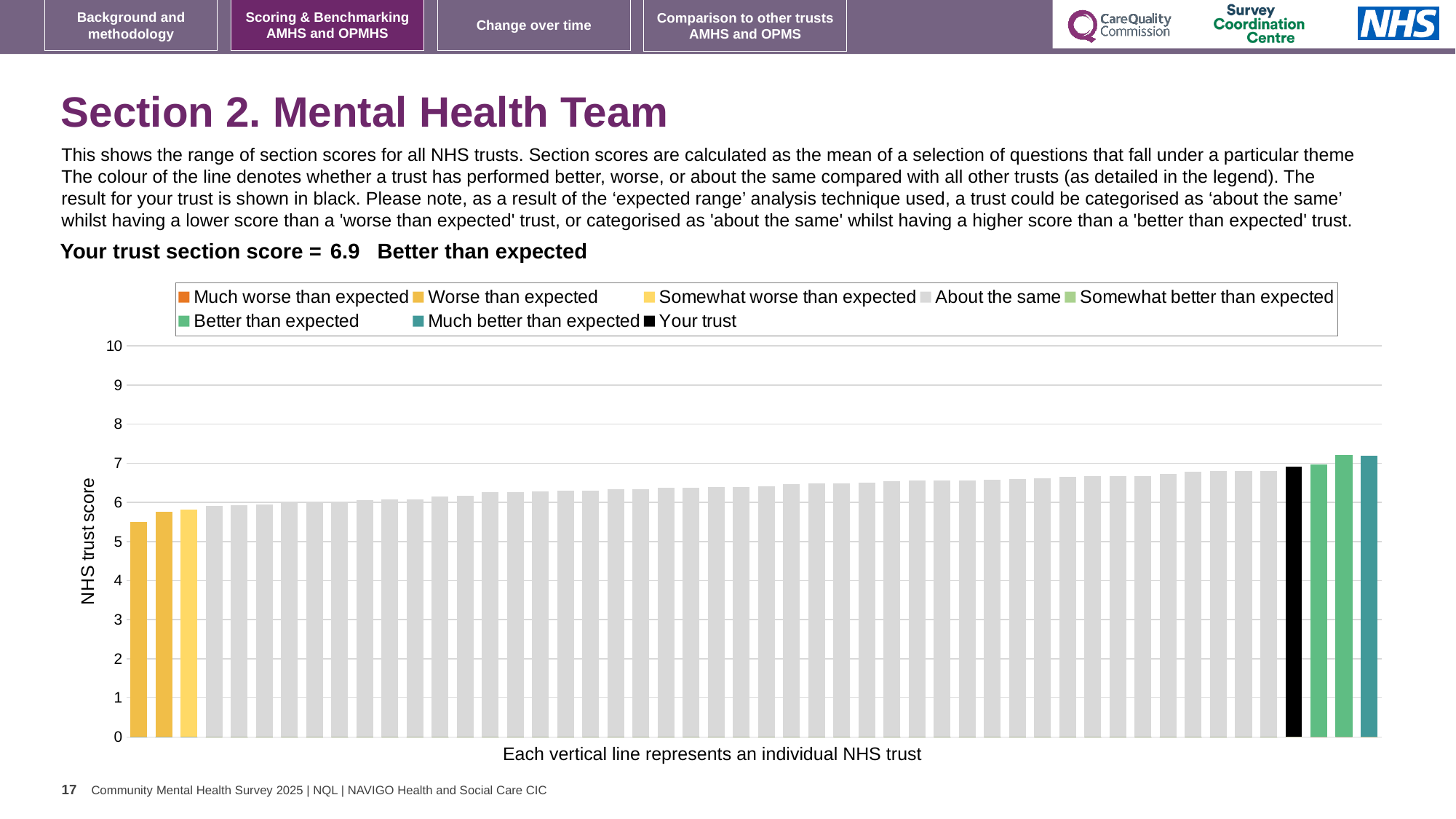
Is the value of the leftmost (lowest) bar greater or less than 5? greater Do the bar heights rise or fall from left to right across the chart? rise Which is taller, the leftmost bar or the rightmost bar? the rightmost bar What kind of chart is shown on the slide? bar chart Is the value of the leftmost (lowest) bar greater or less than 6? less What is the title of the vertical axis? NHS trust score What is the section score for your trust (the black bar)? 6.9 How many bars are coloured black for 'Your trust'? 1 Is the value of the black 'Your trust' bar greater or less than 6? greater How many entries does the chart legend list? 8 Which legend category does the lowest bar belong to? Worse than expected